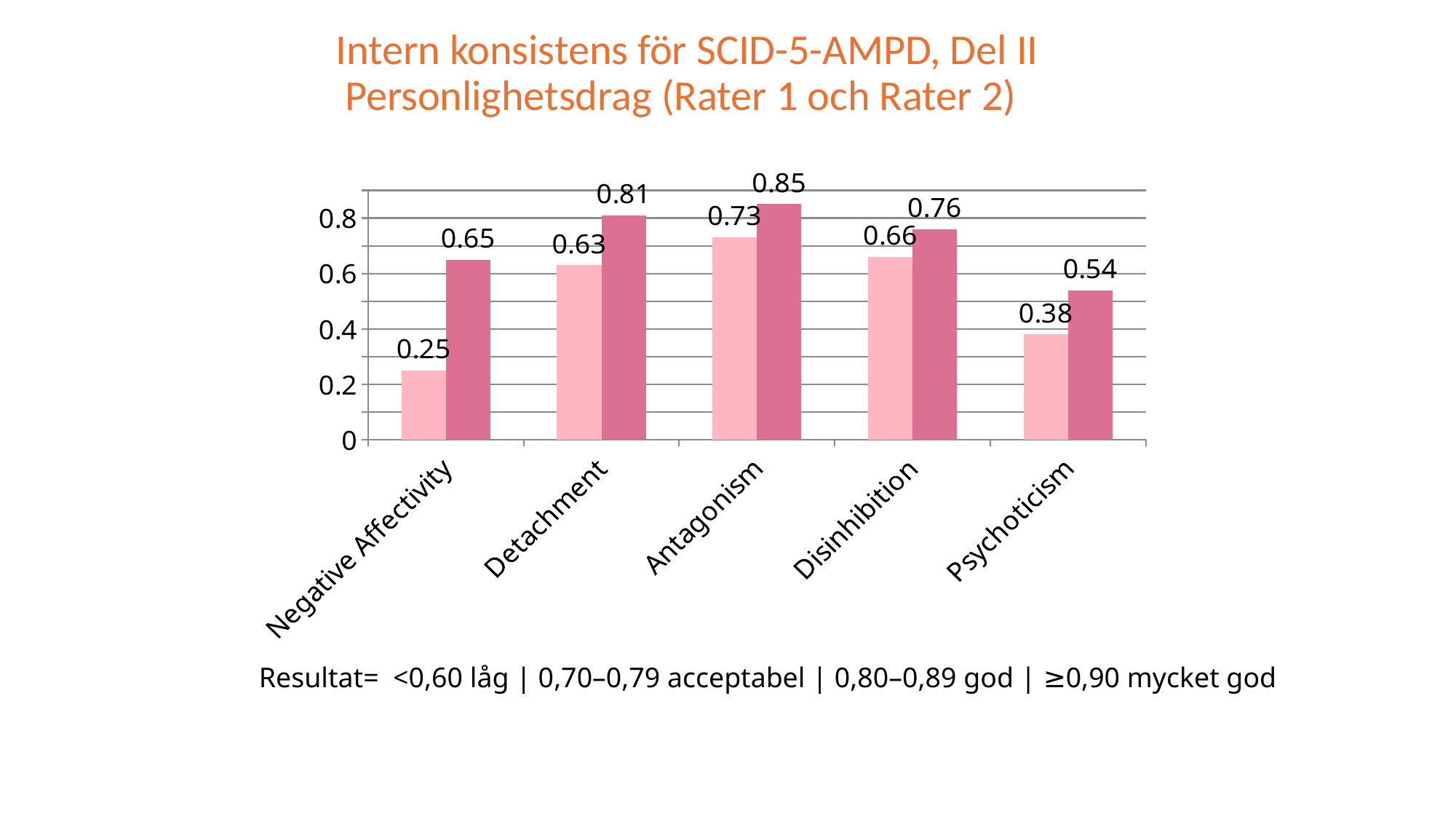
Which category has the highest darker pink bar? Antagonism Which category has the lowest lighter pink bar? Negative Affectivity How many categories are shown on the x axis? 5 What kind of chart is shown on the slide? Bar chart What is the difference between the darker pink bars for Detachment and Psychoticism? 0.27 What is the value of the darker pink bar for Antagonism? 0.85 What is the value of the lighter pink bar for Negative Affectivity? 0.25 Which is larger: the lighter pink bar for Detachment or the lighter pink bar for Disinhibition? Disinhibition What is the difference between the darker pink and lighter pink bars for Negative Affectivity? 0.40 What is the title of the chart? Intern konsistens för SCID-5-AMPD, Del II Personlighetsdrag (Rater 1 och Rater 2) What is the value of the darker pink bar for Disinhibition? 0.76 What is the value of the lighter pink bar for Psychoticism? 0.38